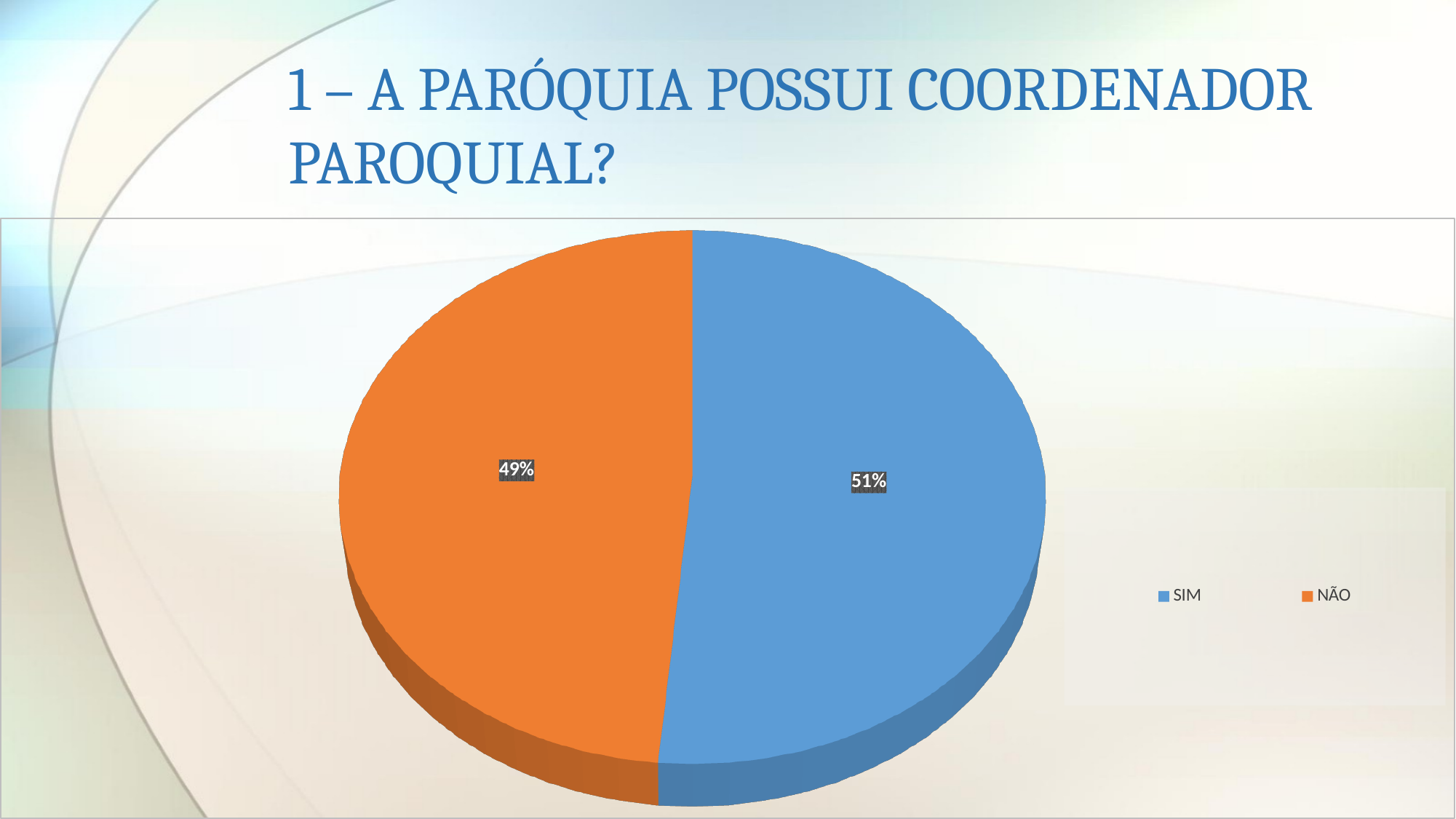
What kind of chart is shown on the slide? Pie chart What colour is the NÃO slice in the pie chart? Orange Which is larger according to the data labels, SIM or NÃO? SIM How many slices does the pie chart have? 2 What percentage of the pie chart is labelled NÃO? 49% What is the difference in percentage points between the SIM and NÃO slices? 2 What is the title of the slide containing the pie chart? 1 – A PARÓQUIA POSSUI COORDENADOR PAROQUIAL? What share of the pie does the SIM slice represent? 51% How many entries does the legend list? 2 Which slice of the pie chart is the smallest? NÃO Which slice of the pie chart is the largest? SIM What percentage of the pie chart is labelled SIM? 51%